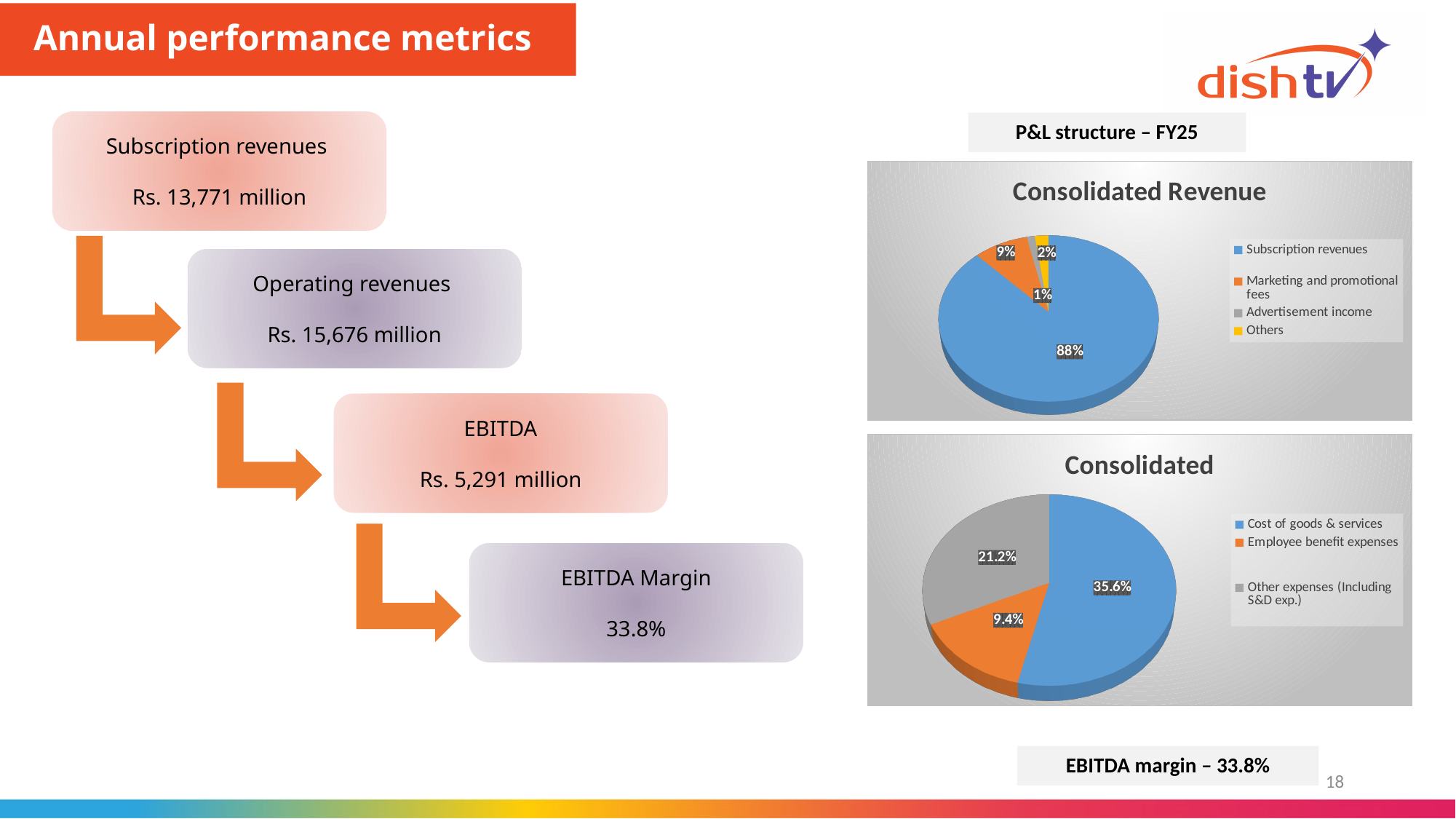
In the Consolidated Revenue chart, how many categories does the legend list? 4 In the Consolidated chart (lower chart), which is larger: Other expenses (Including S&D exp.) or Employee benefit expenses? Other expenses (Including S&D exp.) In the Consolidated Revenue chart, what is the value for Advertisement income? 1% In the Consolidated Revenue chart, what share does Subscription revenues have? 88% What type of chart is the Consolidated Revenue chart? Pie chart In the Consolidated Revenue chart, which category has the largest share? Subscription revenues In the Consolidated Revenue chart, which category has the smallest share? Advertisement income In the Consolidated chart (lower chart), what is the difference between Cost of goods & services and Other expenses (Including S&D exp.)? 14.4% In the Consolidated chart (lower chart), what is the value for Cost of goods & services? 35.6% In the Consolidated Revenue chart, what is the value for Marketing and promotional fees? 9% In the Consolidated chart (lower chart), what is the value for Employee benefit expenses? 9.4% In the Consolidated Revenue chart, what is the difference between Subscription revenues and Marketing and promotional fees? 79%